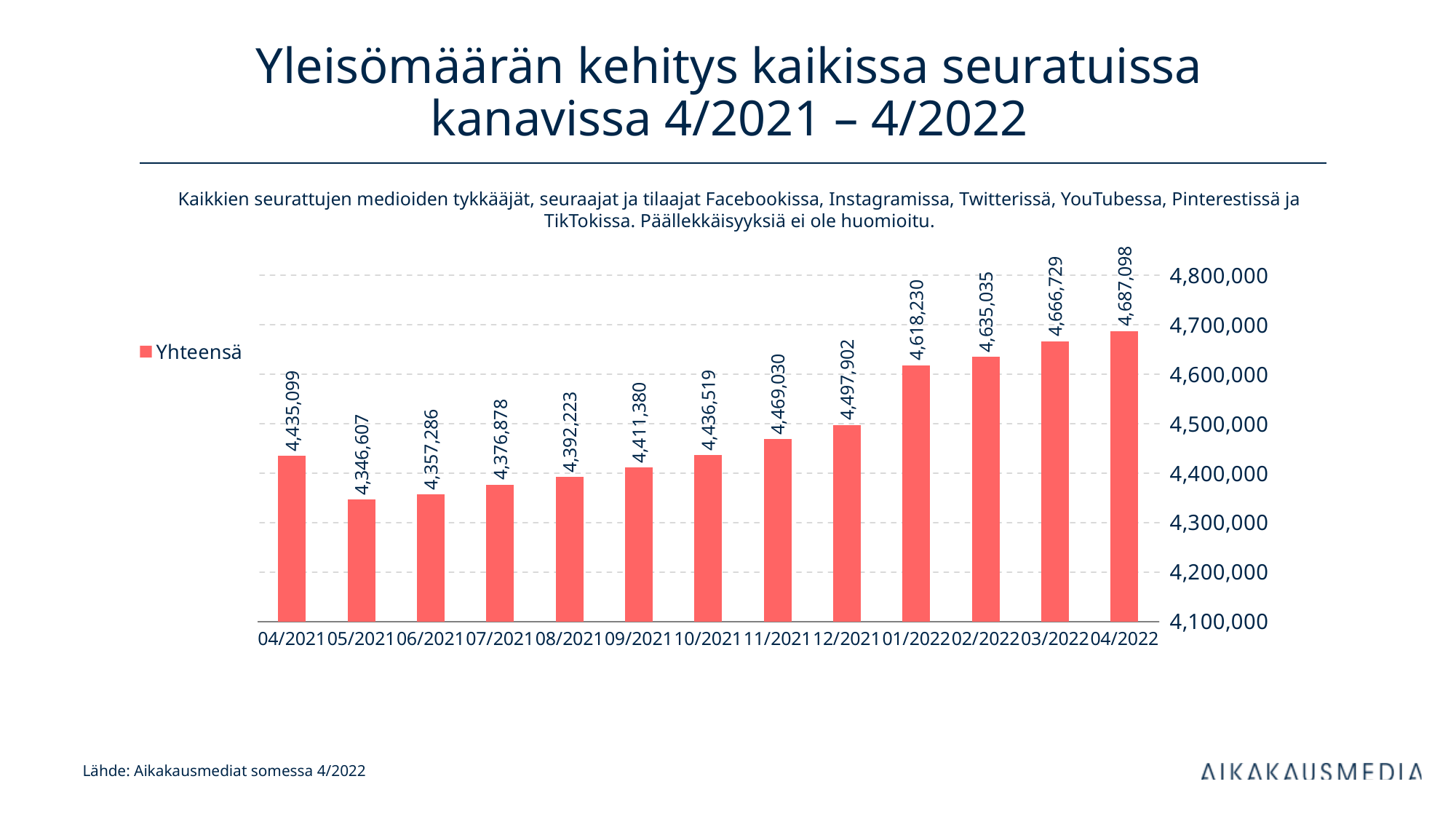
What is the value for 12/2021? 4,497,902 What type of chart is shown on the slide? bar chart What is the difference between the values for 04/2022 and 04/2021? 251,999 What is the difference between the values for 01/2022 and 12/2021? 120,328 Which is larger, the value for 04/2021 or the value for 10/2021? 10/2021 What is the value for 04/2022? 4,687,098 Is the value for 05/2021 greater or less than 4,400,000? less Which month has the lowest value? 05/2021 How many months are shown on the x axis? 13 From 05/2021 to 04/2022, do the values rise or fall? rise Which month has the highest value? 04/2022 What is the value for 04/2021? 4,435,099